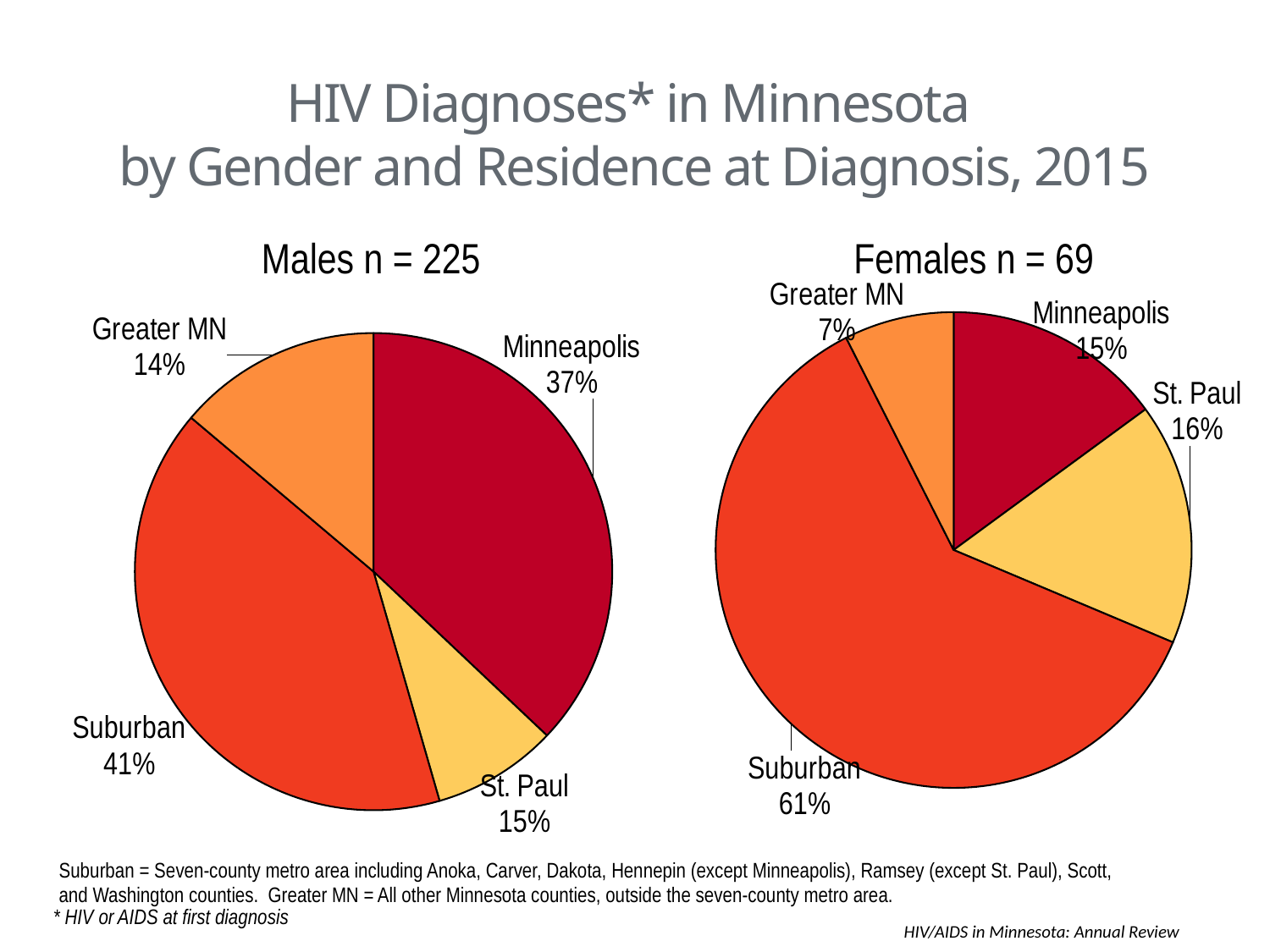
In the Males n = 225 pie chart, which residence category has the largest share? Suburban In the Females n = 69 pie chart, what share of diagnoses is Suburban? 61% In the Males n = 225 pie chart, what share of diagnoses is Minneapolis? 37% How many slices does the Males n = 225 pie chart have? 4 In the Females n = 69 pie chart, which residence category has the smallest share? Greater MN In the Females n = 69 pie chart, what is the combined share of Minneapolis and St. Paul? 31% What type of chart is used for the Females n = 69 data? Pie chart In the Males n = 225 pie chart, what share of diagnoses is Greater MN? 14% In the Males n = 225 pie chart, what is the difference between the Suburban and Minneapolis shares? 4% What is the sample size shown in the title of the Females pie chart? 69 In the Females n = 69 pie chart, which is larger, the St. Paul share or the Greater MN share? St. Paul